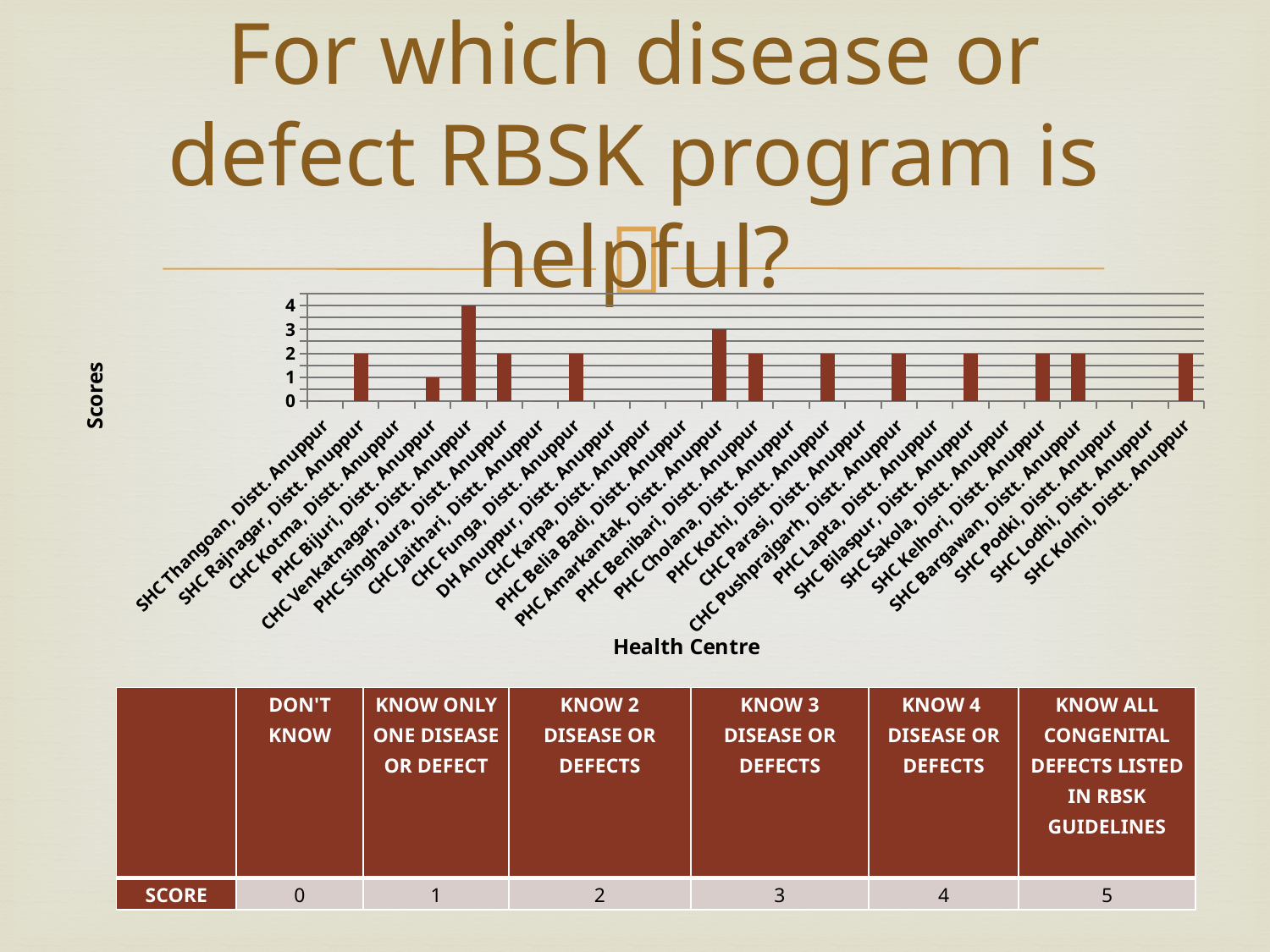
What is the score for SHC Rajnagar, Distt. Anuppur? 2 What is the title of the chart on the slide? For which disease or defect RBSK program is helpful? Which is larger, the score for CHC Venkatnagar, Distt. Anuppur or the score for PHC Amarkantak, Distt. Anuppur? CHC Venkatnagar, Distt. Anuppur What is the score for PHC Amarkantak, Distt. Anuppur? 3 What is the difference between the score for CHC Venkatnagar, Distt. Anuppur and the score for PHC Bijuri, Distt. Anuppur? 3 How many health centres are listed along the x axis of the chart? 25 What is the highest value shown on the vertical axis of the chart? 4 What is the label of the vertical axis of the chart? Scores What kind of chart is shown on the slide? Bar chart Which health centre has the highest score in the chart? CHC Venkatnagar, Distt. Anuppur What is the score for CHC Venkatnagar, Distt. Anuppur? 4 What is the score for PHC Bijuri, Distt. Anuppur? 1